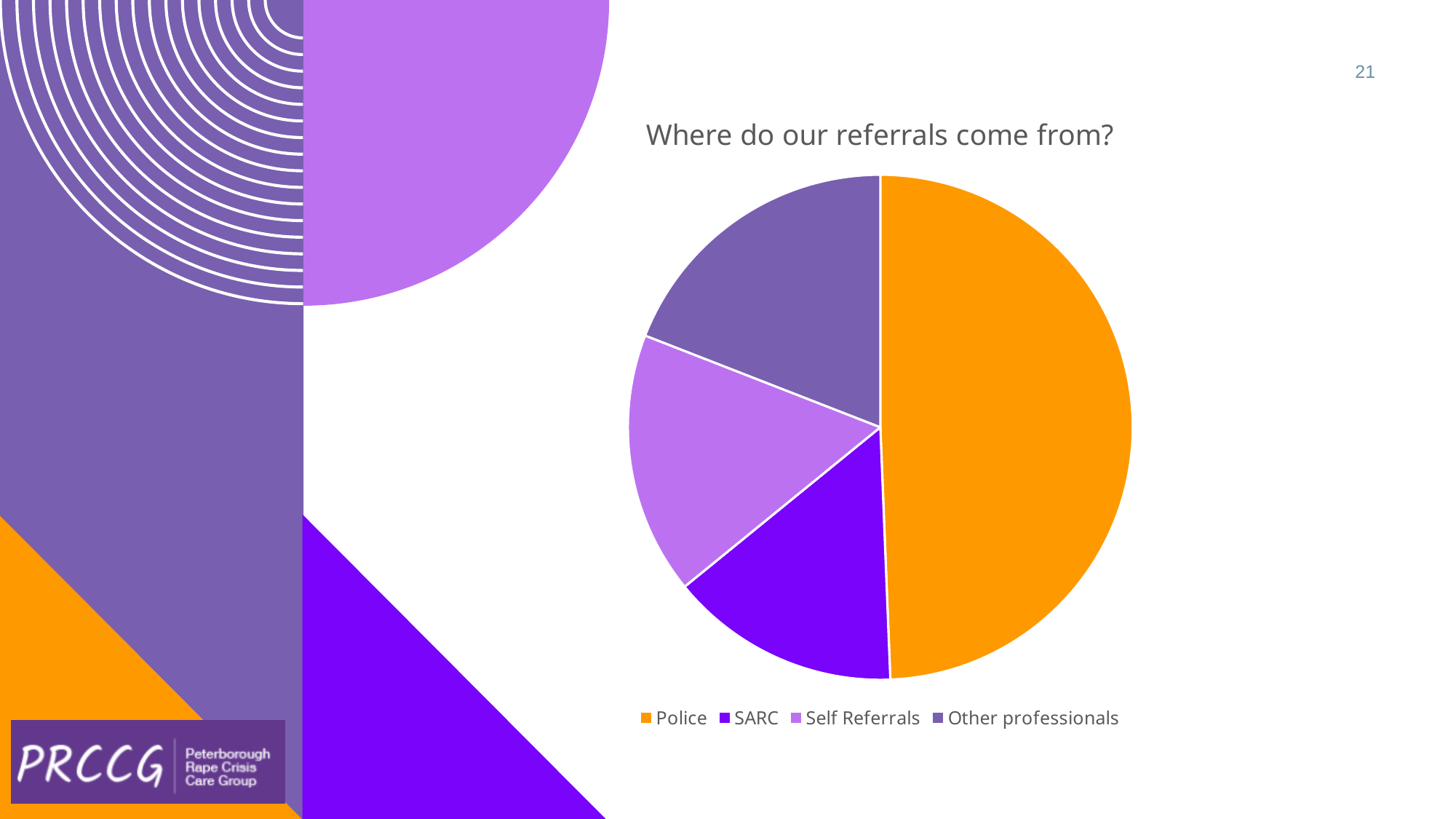
Which referral source has the largest slice of the pie? Police Which is larger, the slice for Police or the slice for SARC? Police How many entries does the legend list? 4 Which referral source has the smallest slice of the pie? SARC What is the title of the chart? Where do our referrals come from? How many categories (slices) does the pie chart have? 4 Which is larger, the slice for Self Referrals or the slice for SARC? Self Referrals What kind of chart is shown on the slide? pie chart Which is larger, the slice for Police or the slice for Other professionals? Police What colour is the Police slice in the pie chart? orange